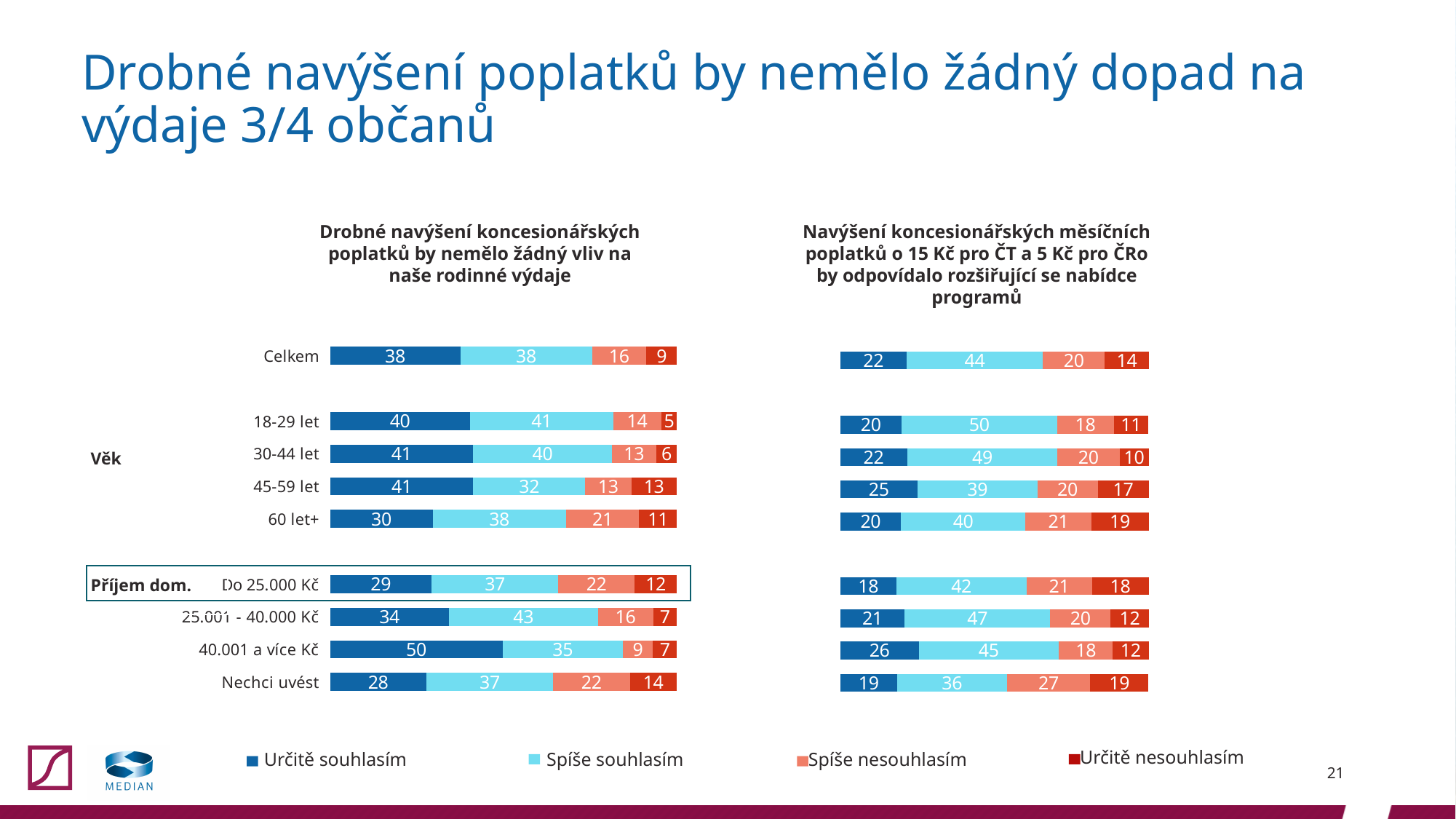
In the left chart (Drobné navýšení koncesionářských poplatků by nemělo žádný vliv na naše rodinné výdaje), what is the Určitě souhlasím value for 40.001 a více Kč? 50 In the right chart, which category has the lowest Určitě souhlasím value? Do 25.000 Kč In the left chart, which category has the highest Určitě souhlasím value? 40.001 a více Kč How many series does the legend list? 4 In the right chart, which is larger: the Určitě nesouhlasím value for 60 let+ or for 30-44 let? 60 let+ In the left chart, what is the difference between the Spíše nesouhlasím values for Do 25.000 Kč and 40.001 a více Kč? 13 Which legend entry is shown in dark blue? Určitě souhlasím What kind of chart is used on this slide? Stacked bar chart How many categories (rows) are plotted in the left chart? 9 In the right chart (Navýšení koncesionářských měsíčních poplatků o 15 Kč pro ČT a 5 Kč pro ČRo...), what is the Spíše souhlasím value for 18-29 let? 50 In the right chart, what is the total of the stacked bar for Celkem? 100 In the left chart, what is the Určitě nesouhlasím value for Nechci uvést? 14